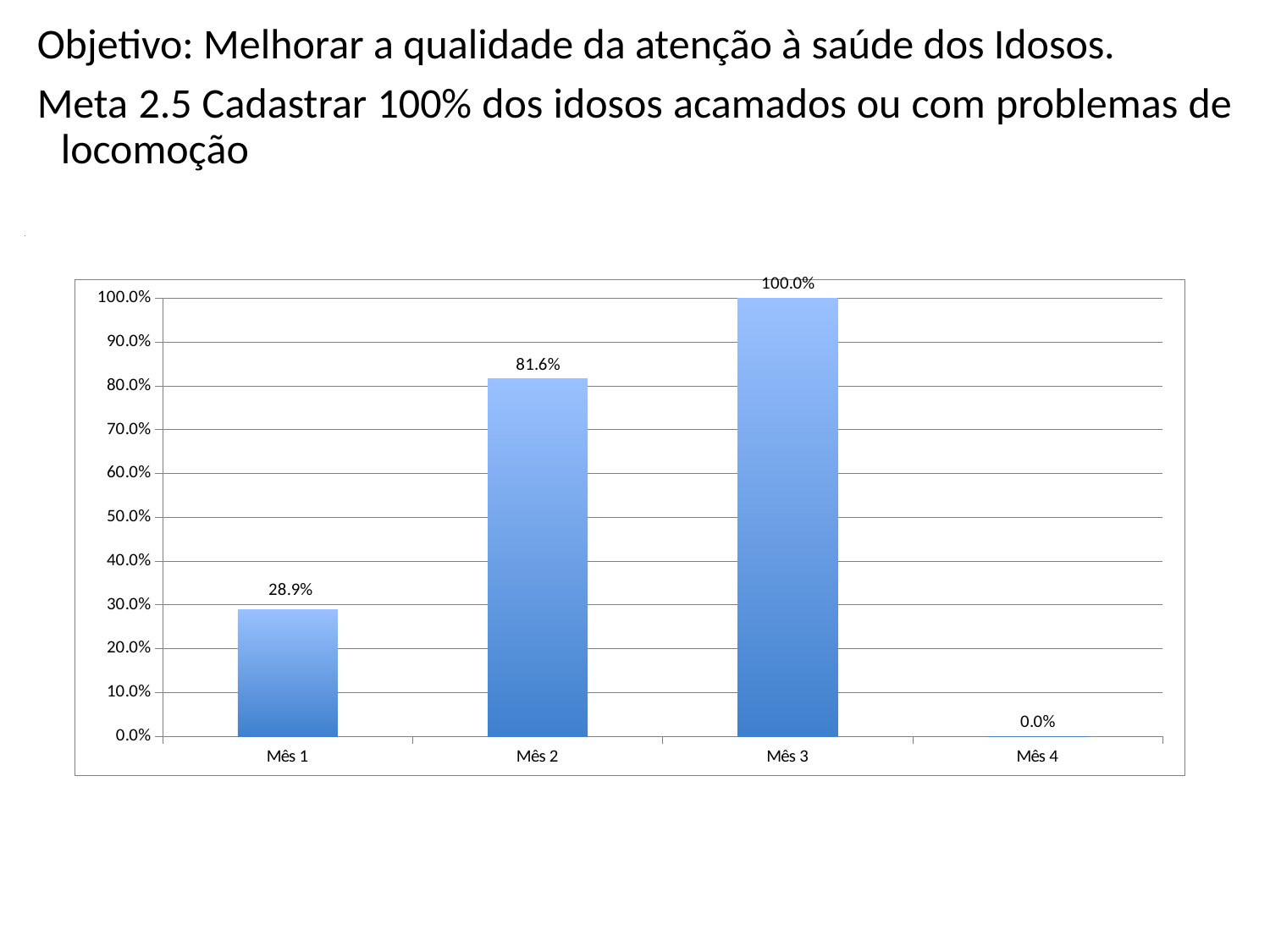
Which category has the highest value? Mês 3 What is the difference between the values for Mês 3 and Mês 2? 18.4% What is the difference between the values for Mês 2 and Mês 1? 52.7% What is the value for Mês 1? 28.9% What is the value for Mês 3? 100.0% Is the value for Mês 1 greater or less than 30.0%? less What is the value for Mês 4? 0.0% How many categories are shown on the x axis? 4 What kind of chart is shown on the slide? bar chart Which is larger, the value for Mês 1 or the value for Mês 2? Mês 2 Which category has the lowest value? Mês 4 What is the value for Mês 2? 81.6%